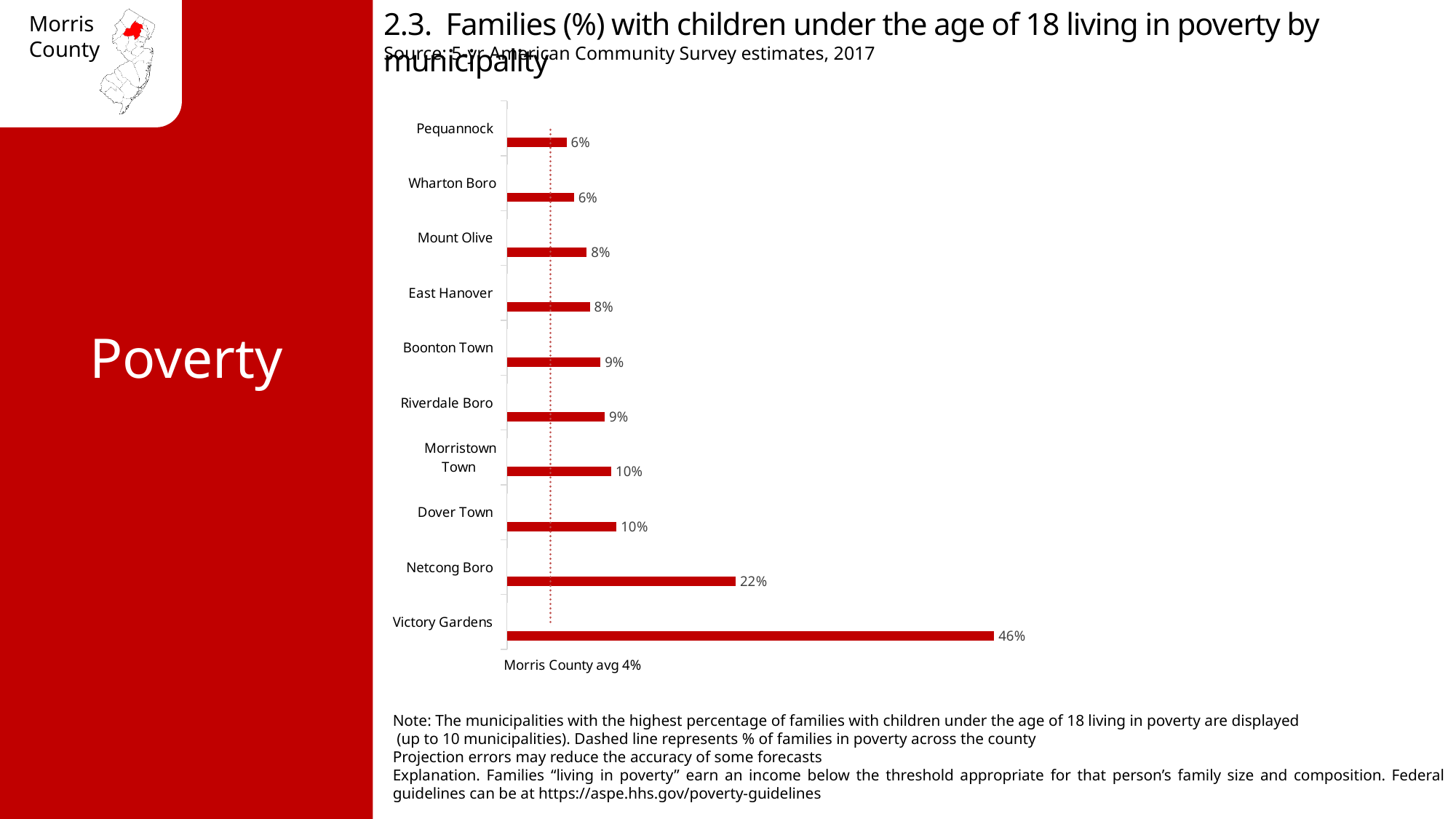
How many municipalities are shown in the chart? 10 Which municipality has the highest value? Victory Gardens What Morris County average value does the dashed line represent? 4% What is the value for Victory Gardens? 46% What is the difference between the values for Dover Town and Pequannock? 4% What is the value for Boonton Town? 9% What is the source of the data shown in the chart? 5-yr American Community Survey estimates, 2017 Which is larger, the value for Netcong Boro or the value for Morristown Town? Netcong Boro What kind of chart is shown on the slide? Bar chart What is the value for Mount Olive? 8% What is the difference between the values for Victory Gardens and Netcong Boro? 24% What is the value for Netcong Boro? 22%